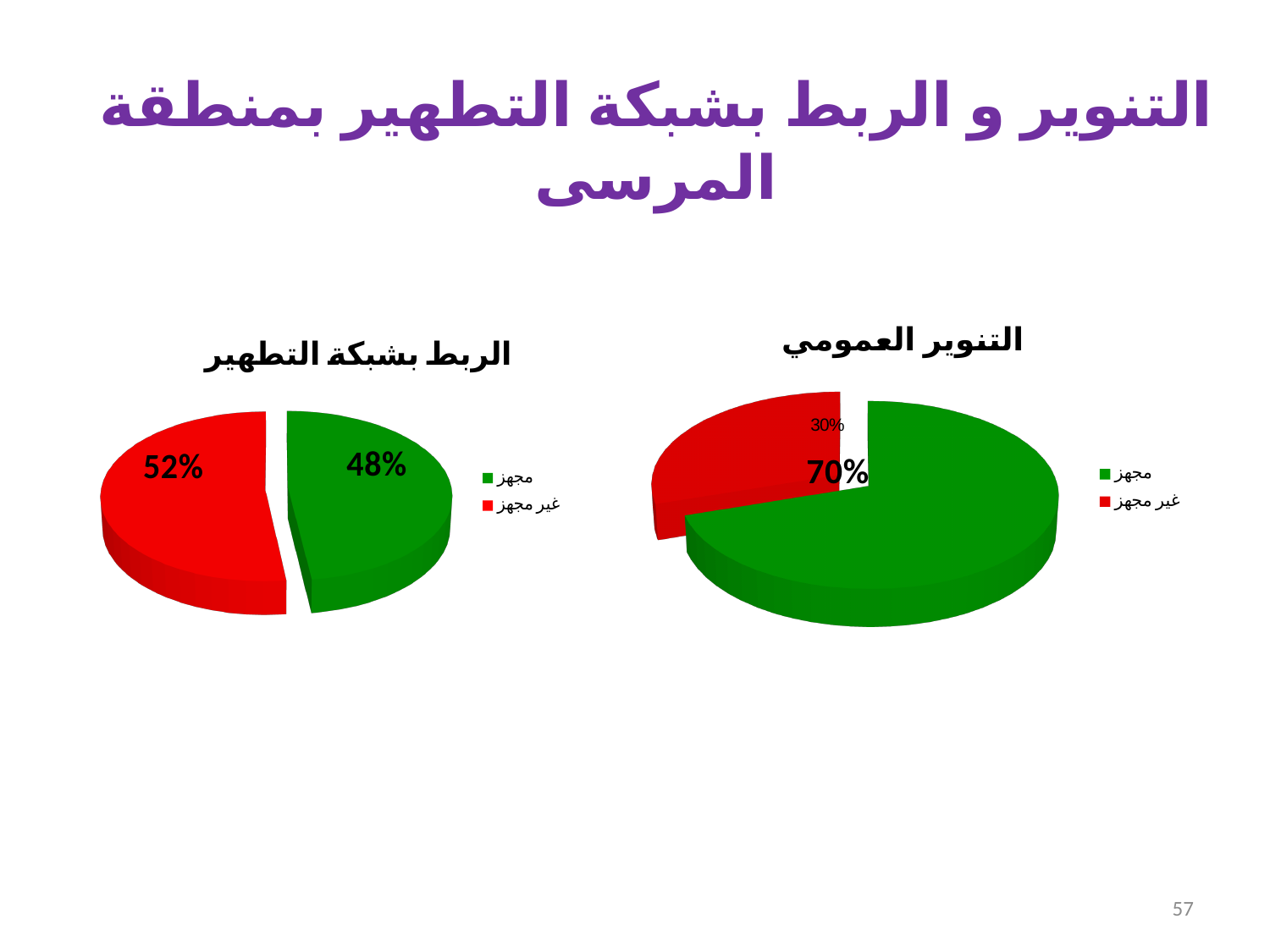
In the chart titled "التنوير العمومي", what is the value for "مجهز"? 70% In the chart titled "التنوير العمومي", what is the value for "غير مجهز"? 30% In the chart titled "التنوير العمومي", what colour is the "غير مجهز" slice? Red In the chart titled "الربط بشبكة التطهير", what is the value for "غير مجهز"? 52% In the chart titled "الربط بشبكة التطهير", what is the value for "مجهز"? 48% In the chart titled "التنوير العمومي", which category has the largest slice? مجهز In the chart titled "التنوير العمومي", what is the difference between the "مجهز" and "غير مجهز" values? 40% What kind of chart is the chart titled "التنوير العمومي" on the right of the slide? Pie chart In the chart titled "الربط بشبكة التطهير", what is the difference between the "غير مجهز" and "مجهز" values? 4% In the chart titled "الربط بشبكة التطهير", which category has the smallest slice? مجهز Which is larger: the "مجهز" value in the chart titled "التنوير العمومي" or the "مجهز" value in the chart titled "الربط بشبكة التطهير"? التنوير العمومي How many slices does the chart titled "الربط بشبكة التطهير" have? 2